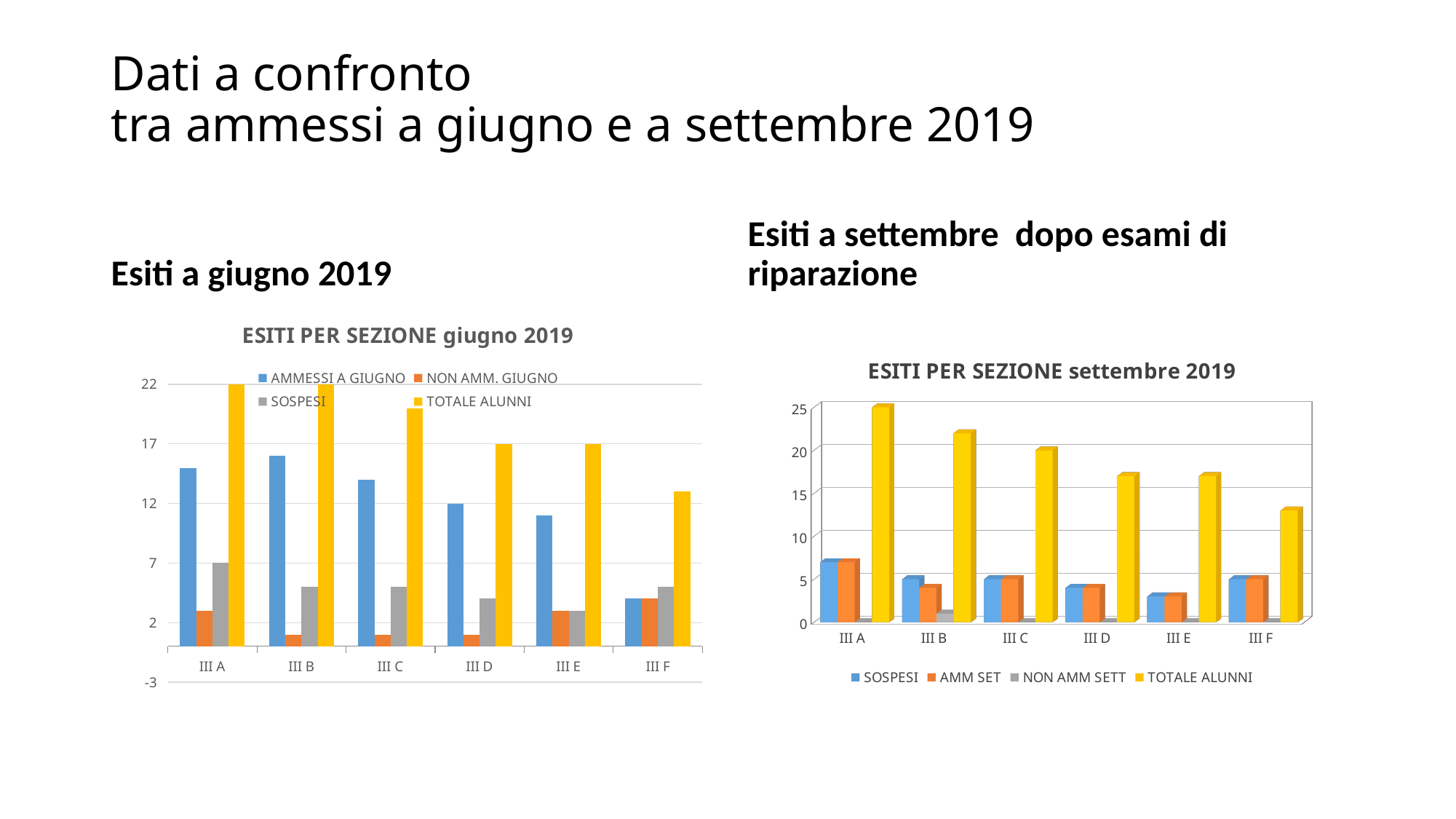
How many sections (categories) are shown on the x axis of the 'ESITI PER SEZIONE giugno 2019' chart? 6 In the 'ESITI PER SEZIONE giugno 2019' chart, which section has the highest SOSPESI value? III A Which colour represents TOTALE ALUNNI in the 'ESITI PER SEZIONE settembre 2019' chart? yellow In the 'ESITI PER SEZIONE settembre 2019' chart, which section has the highest TOTALE ALUNNI? III A In the 'ESITI PER SEZIONE settembre 2019' chart, is the SOSPESI value for III A greater or less than 5? greater In the 'ESITI PER SEZIONE giugno 2019' chart, is the TOTALE ALUNNI value for III F greater or less than 17? less In the 'ESITI PER SEZIONE settembre 2019' chart, which is larger: TOTALE ALUNNI for III A or for III B? III A What kind of chart is the 'ESITI PER SEZIONE giugno 2019' chart on the left? bar chart In the 'ESITI PER SEZIONE giugno 2019' chart, is the AMMESSI A GIUGNO value for III A greater or less than 12? greater How many series does the legend of the 'ESITI PER SEZIONE settembre 2019' chart list? 4 In the 'ESITI PER SEZIONE settembre 2019' chart, which section has the lowest TOTALE ALUNNI? III F In the 'ESITI PER SEZIONE giugno 2019' chart, which section has the lowest TOTALE ALUNNI? III F